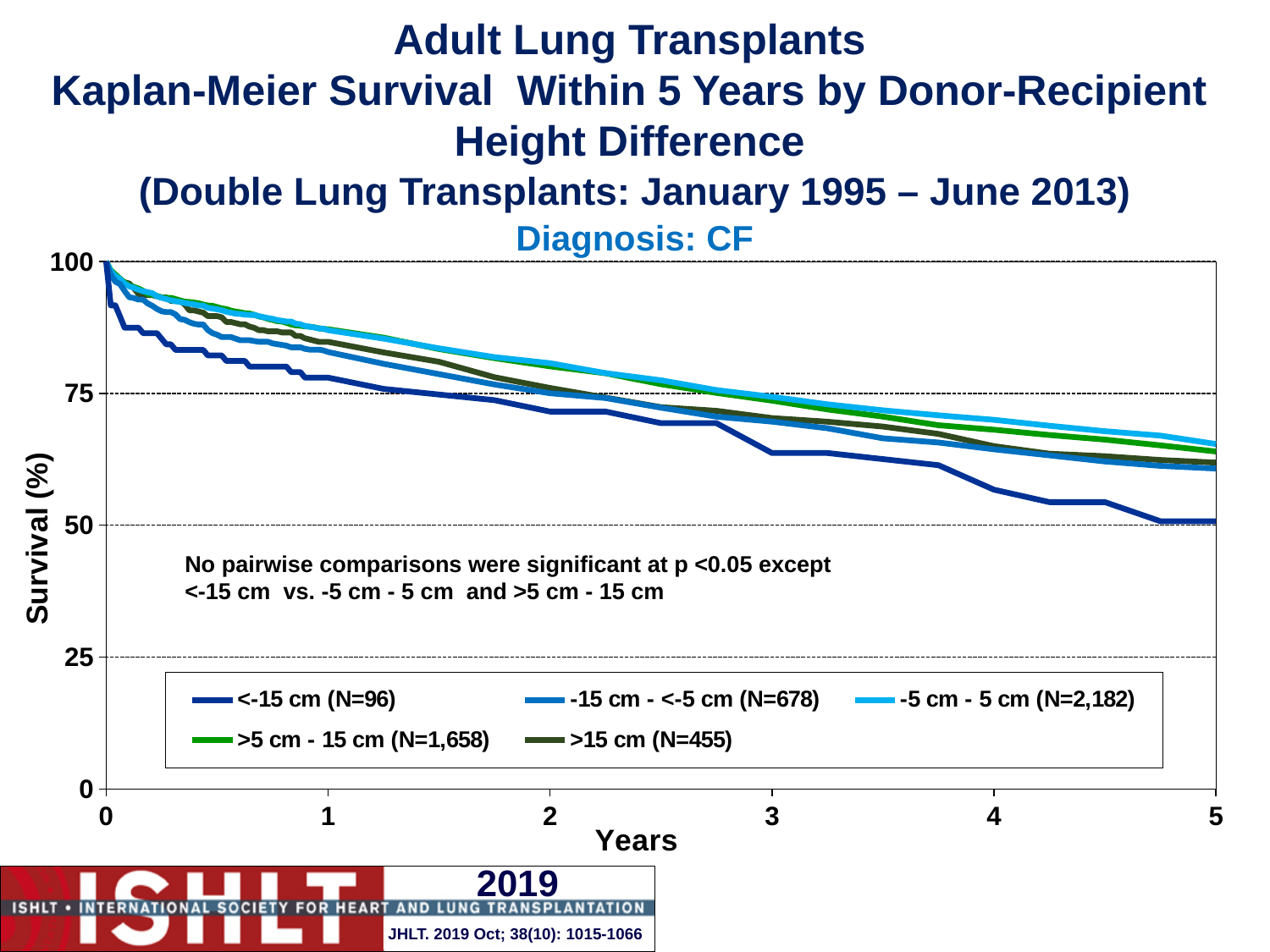
What kind of chart is shown on the slide? line chart Is the survival for the <-15 cm group at 4 years greater or less than 75? less How many series does the legend list? 5 At 3 years, which has higher survival: the <-15 cm group or the -5 cm - 5 cm group? -5 cm - 5 cm Is the survival for the -5 cm - 5 cm group at 5 years greater or less than 50? greater Do the survival curves rise or fall as years increase? fall What is the N for the >15 cm group in the legend? 455 Which height-difference group has the lowest survival at 5 years? <-15 cm (N=96) Is the survival for the >15 cm group at 2 years greater or less than 50? greater What is the maximum value shown on the Years axis? 5